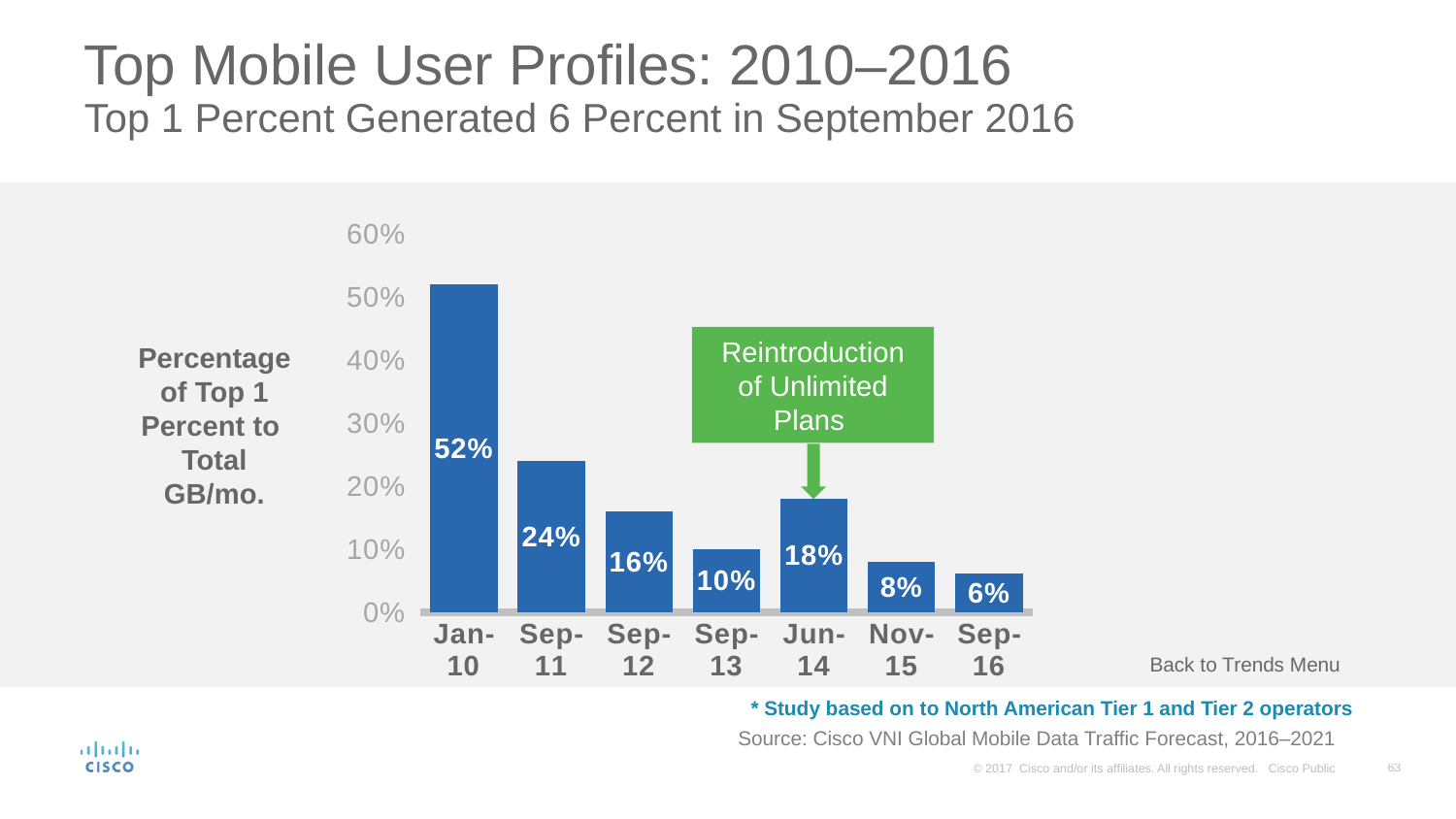
How many categories are shown on the x axis? 7 What event does the green callout box on the chart label? Reintroduction of Unlimited Plans Which category has the highest value? Jan-10 What is the value for Jan-10? 52% What kind of chart is shown on the slide? bar chart Is the value for Sep-11 greater or less than 20%? greater Which category has the lowest value? Sep-16 Which is larger, the value for Sep-13 or the value for Jun-14? Jun-14 What is the value for Jun-14? 18% What is the difference between the values for Sep-11 and Sep-12? 8% What is the value for Sep-16? 6% What is the difference between the values for Jan-10 and Sep-16? 46%